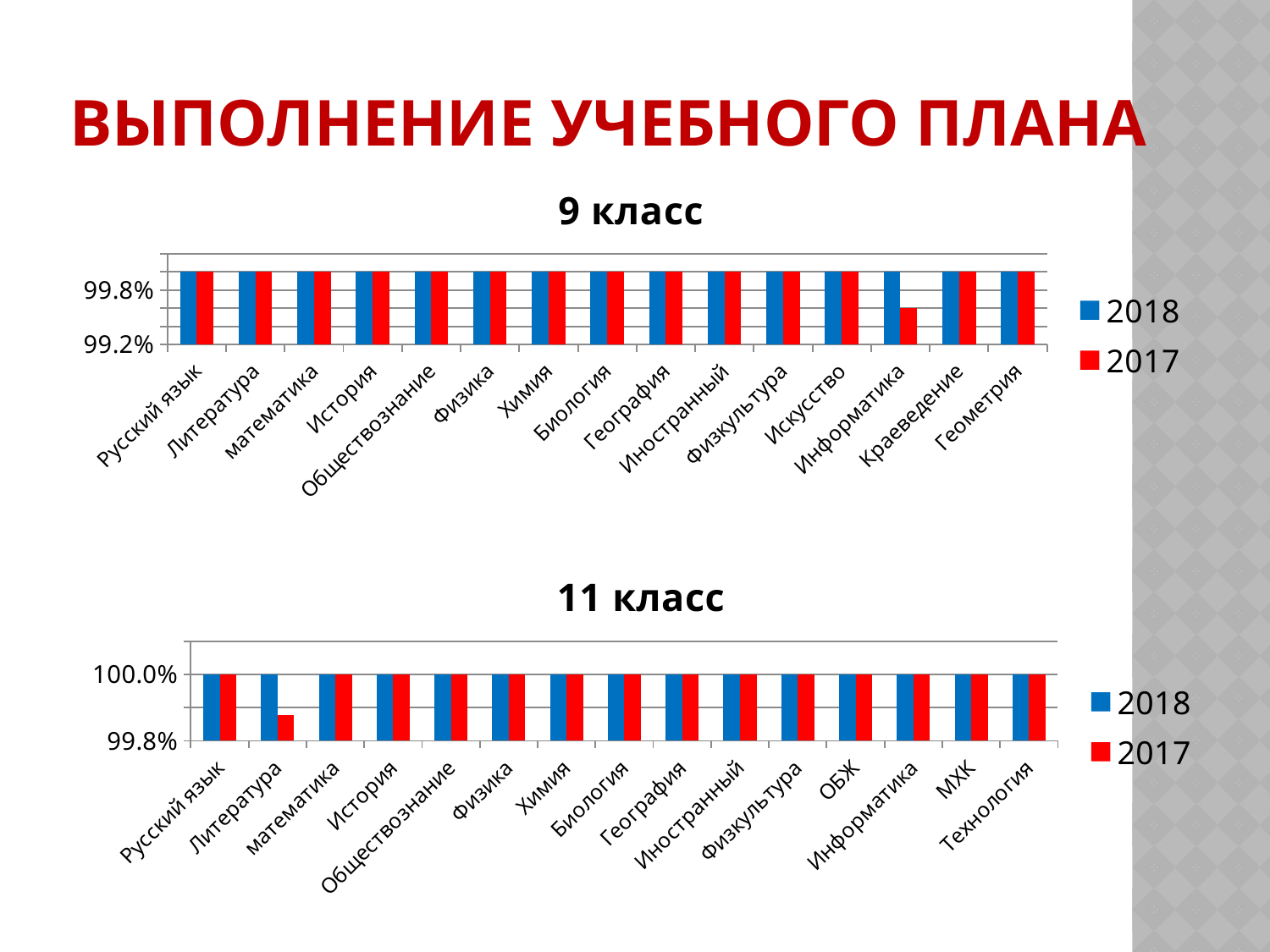
In the "11 класс" chart, which is larger for Литература: the 2018 value or the 2017 value? 2018 How many subject categories are shown on the x axis of the "9 класс" chart? 15 How many series does the legend of the "11 класс" chart list? 2 In the "9 класс" chart, is the 2017 value for Информатика greater or less than 99.8%? less In the "9 класс" chart, is the 2018 value for Русский язык greater or less than 99.8%? greater In the "9 класс" chart, which subject has the lowest value for 2017? Информатика In the "11 класс" chart, which subject has the lowest value for 2017? Литература In the "11 класс" chart, is the 2017 value for Литература greater or less than 99.8%? greater What kind of chart is the "9 класс" chart? bar chart What are the two legend entries of the "9 класс" chart? 2018 and 2017 In the "9 класс" chart, which is larger for Информатика: the 2018 value or the 2017 value? 2018 How many subject categories are shown on the x axis of the "11 класс" chart? 15